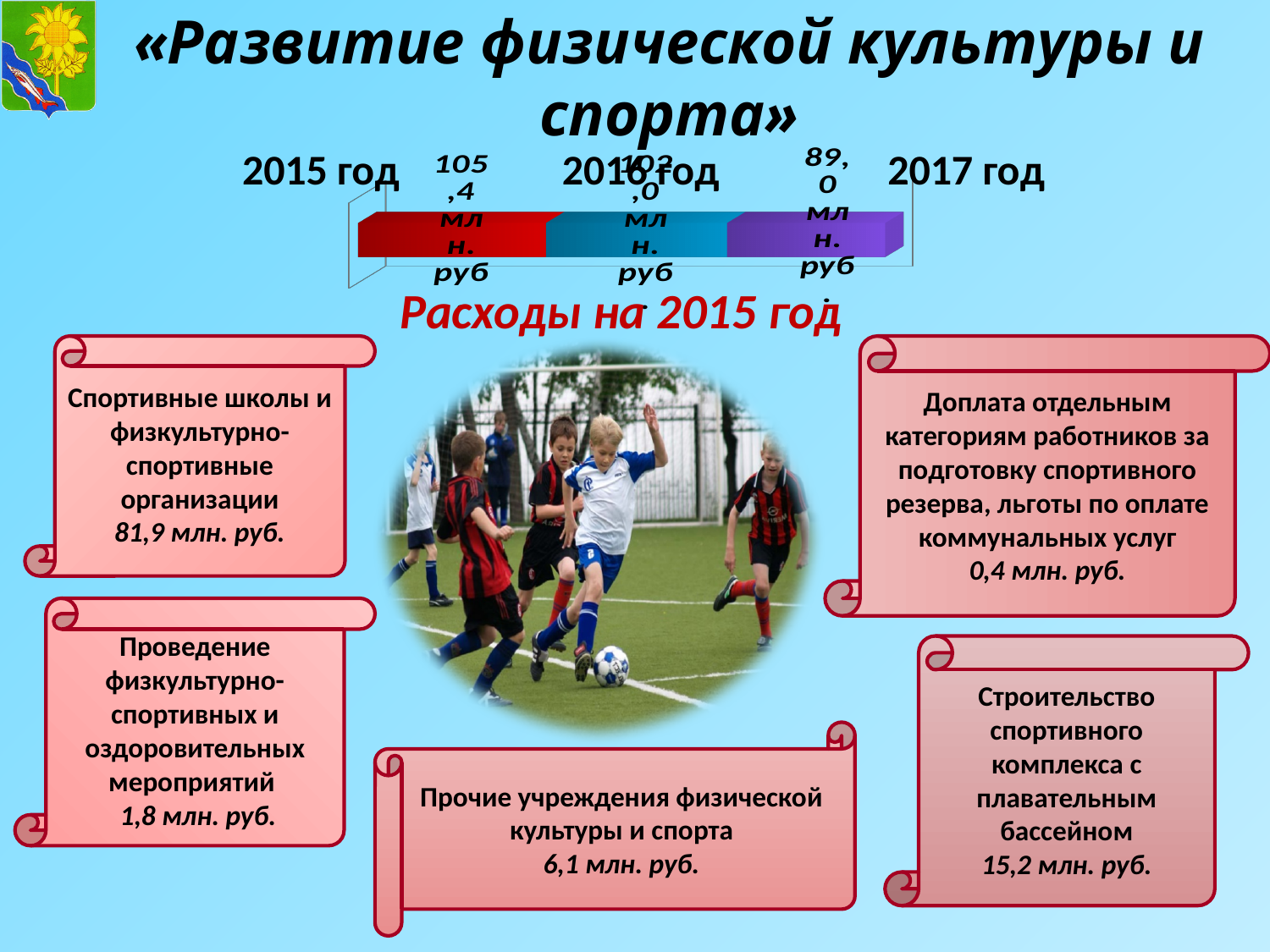
What is the value shown for 2015 год on the bar chart? 105,4 млн. руб What colour is the segment for 2015 год on the bar chart? Red How many years (segments) are shown on the bar chart? 3 Which year has the lowest value on the bar chart? 2017 год What kind of chart is shown at the top of the slide? Bar chart What is the value shown for 2017 год on the bar chart? 89,0 млн. руб What is the difference between the values for 2015 год and 2017 год on the bar chart? 16,4 млн. руб What colour is the segment for 2017 год on the bar chart? Purple Do the values on the bar chart rise or fall from 2015 год to 2017 год? Fall Which is larger on the bar chart, the value for 2015 год or for 2017 год? 2015 год